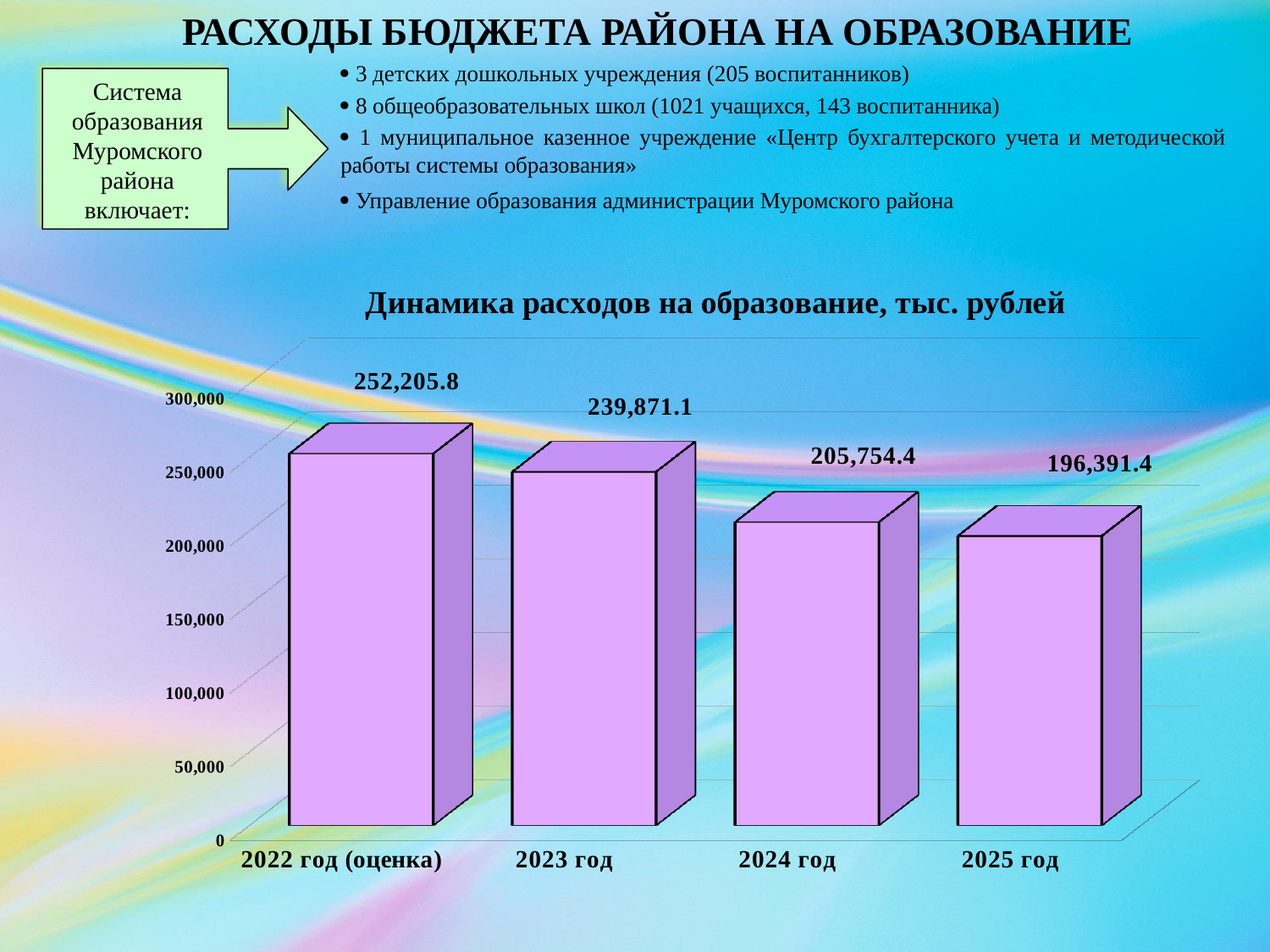
What is the value for 2025 год? 196,391.4 What is the value for 2022 год (оценка)? 252,205.8 Which is larger, the value for 2023 год or the value for 2024 год? 2023 год Is the value for 2024 год greater or less than 200,000? greater Which year has the highest value? 2022 год (оценка) Do the values rise or fall from 2022 год (оценка) to 2025 год? fall Which year has the lowest value? 2025 год What is the difference between the values for 2024 год and 2025 год? 9,363.0 What kind of chart is shown on the slide? bar chart How many years are shown on the x axis? 4 What is the value for 2023 год? 239,871.1 What is the difference between the values for 2022 год (оценка) and 2023 год? 12,334.7